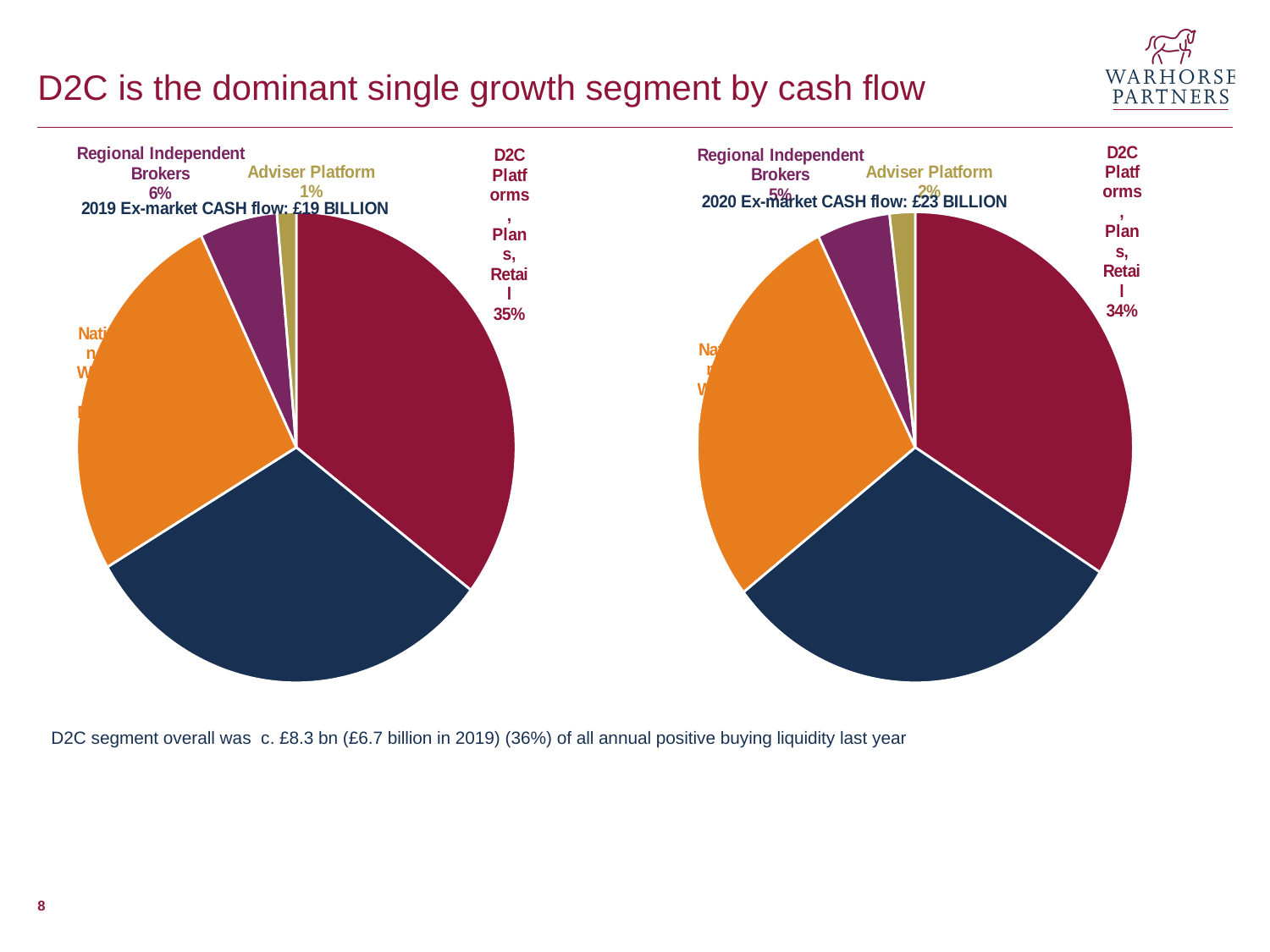
In the 2020 Ex-market CASH flow pie chart, what share is labelled for D2C Platforms, Plans, Retail? 34% In the 2019 Ex-market CASH flow pie chart, what share is labelled for Adviser Platform? 1% How many slices does the 2020 Ex-market CASH flow pie chart have? 5 In the 2019 Ex-market CASH flow pie chart, which is larger: Regional Independent Brokers or Adviser Platform? Regional Independent Brokers According to the title of the right-hand pie chart, what was the 2020 Ex-market cash flow? £23 BILLION In the 2020 Ex-market CASH flow pie chart, what share is labelled for Adviser Platform? 2% In the 2020 Ex-market CASH flow pie chart, how many percentage points larger is D2C Platforms, Plans, Retail than Regional Independent Brokers? 29 percentage points In the 2019 Ex-market CASH flow pie chart, which labelled segment has the smallest share? Adviser Platform In the 2019 Ex-market CASH flow pie chart, what share is labelled for D2C Platforms, Plans, Retail? 35% In the 2020 Ex-market CASH flow pie chart, what share is labelled for Regional Independent Brokers? 5% What kind of chart is used for the 2019 Ex-market CASH flow? Pie chart In the 2019 Ex-market CASH flow pie chart, what share is labelled for Regional Independent Brokers? 6%